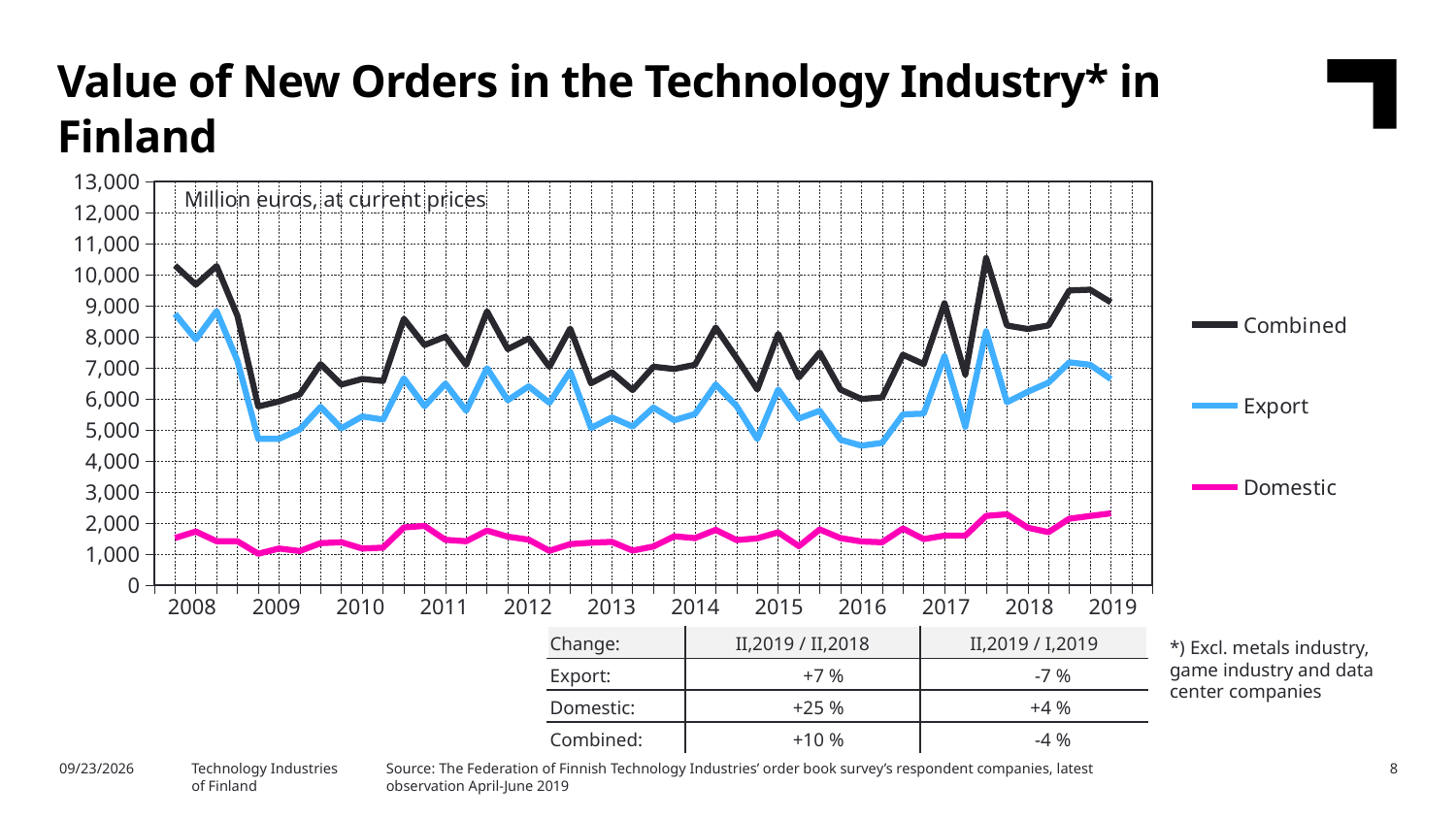
Is the value for Combined at the start of 2008 greater or less than 9,000? greater Which is larger in 2019, the Combined value or the Export value? Combined Does the Combined series rise or fall from the start of 2008 to the start of 2009? fall Which series is plotted with the highest values throughout the chart? Combined What kind of chart is shown on the slide? line chart Is the value for Domestic at the end of 2019 greater or less than 3,000? less Is the peak value for Combined in 2017 greater or less than 10,000? greater Which series is plotted with the lowest values throughout the chart? Domestic How many series does the chart legend list? 3 What unit is stated in the label inside the chart area? Million euros, at current prices How many year labels are shown on the x axis? 12